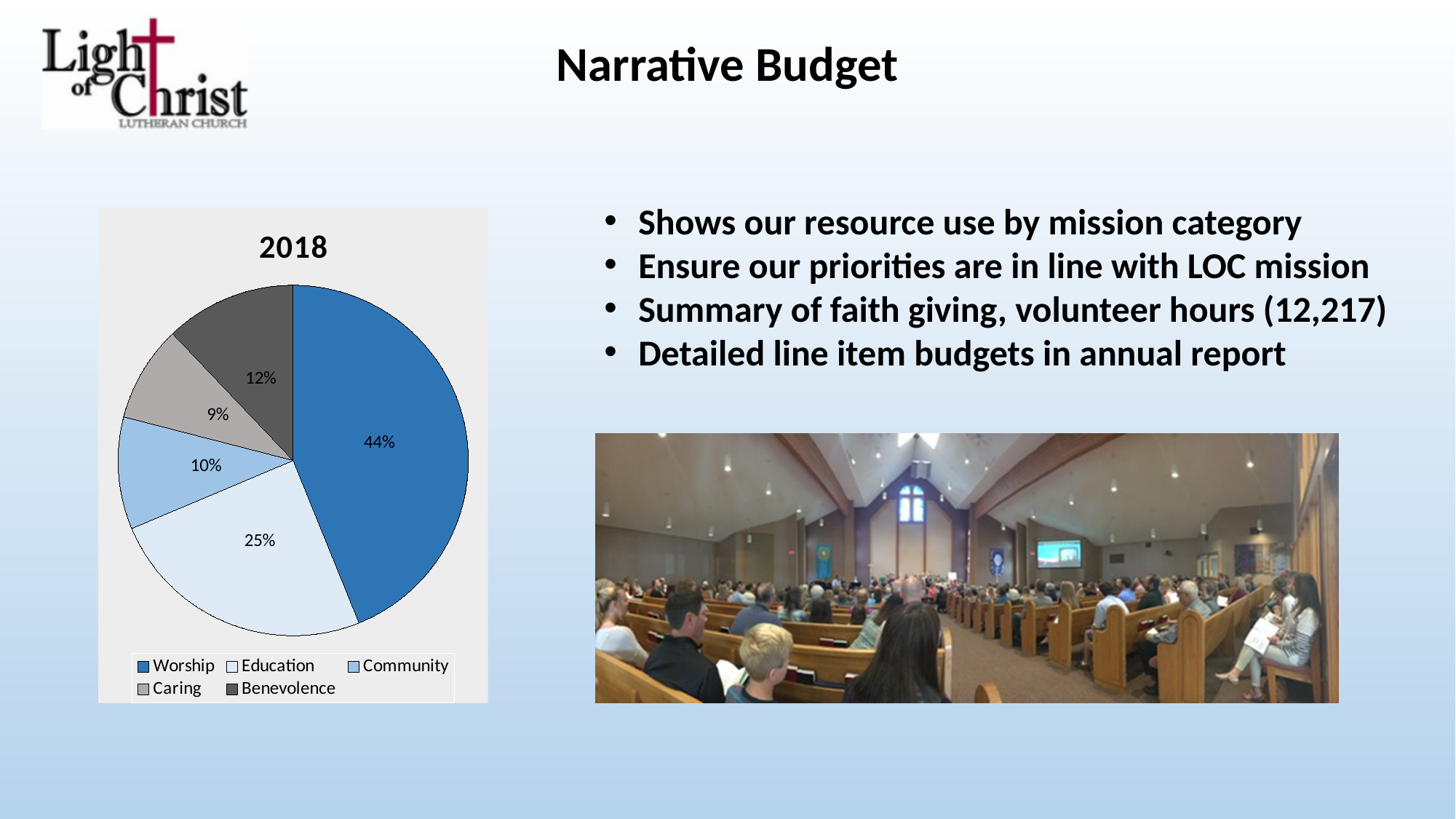
Which slice is larger, Benevolence or Community? Benevolence What is the difference in percentage points between the Worship and Education slices? 19% What kind of chart is shown on the slide? pie chart How many categories does the 2018 pie chart show? 5 What share of the 2018 pie does Education take? 25% What share of the 2018 pie does Community take? 10% What share of the 2018 pie does Caring take? 9% What is the title of the pie chart? 2018 Which category has the smallest slice of the 2018 pie? Caring Which category has the largest slice of the 2018 pie? Worship